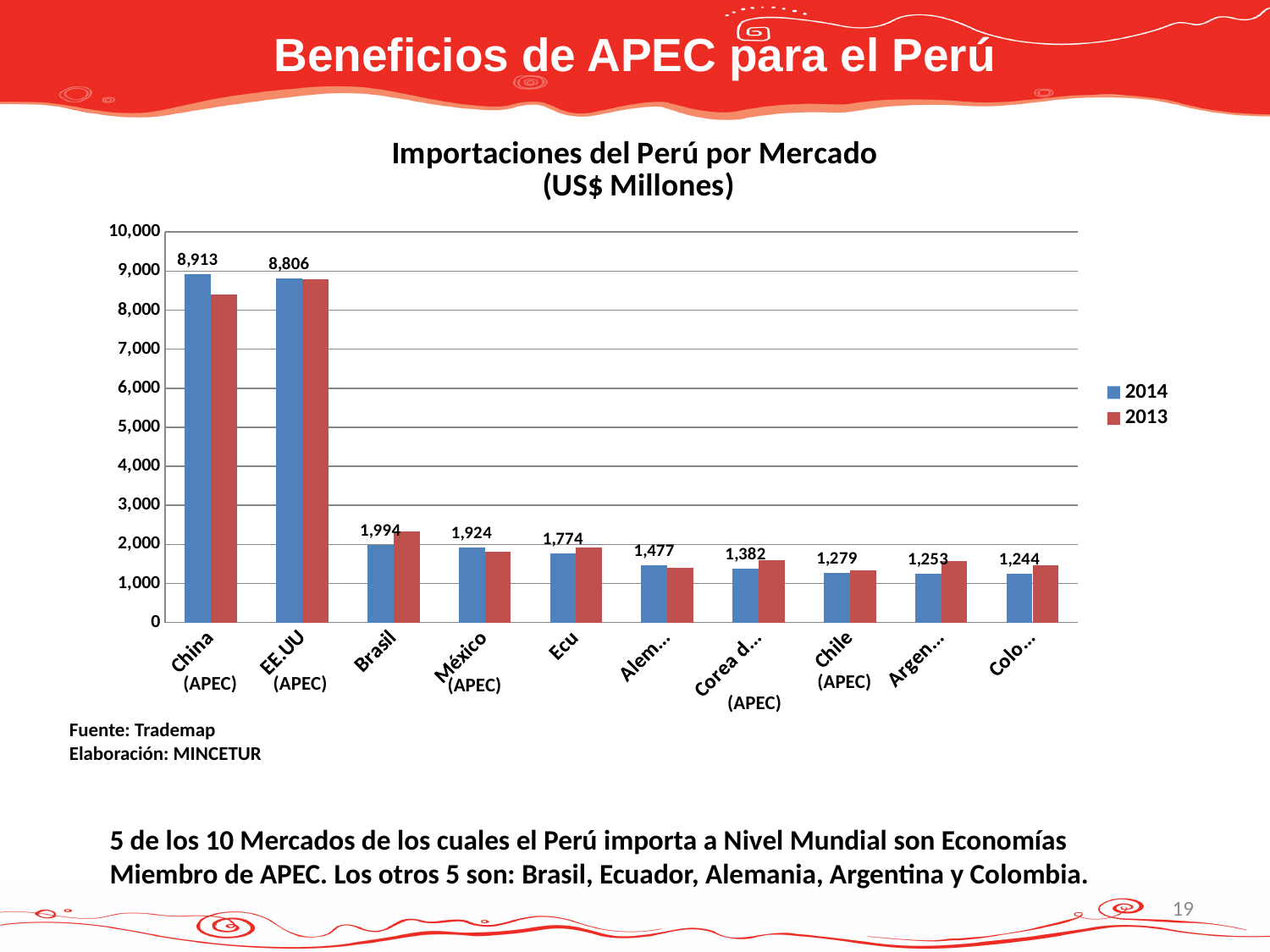
What was the 2014 import value for EE.UU shown on the chart? 8,806 Which market has the highest 2014 import value in the chart? China What is the difference between the 2014 values for Brasil and México? 70 For China, which year has the larger bar, 2014 or 2013? 2014 What was the value of Peru's imports from China in 2014, according to the chart? 8,913 Do the 2014 values rise or fall moving from left to right along the x axis? fall How many series does the legend list? 2 What is the 2014 value labelled for Brasil? 1,994 Which of the labelled markets has the lowest 2014 import value? Colombia Is the 2013 value for Brasil greater or less than 2,000? greater What is the 2014 value labelled for Chile? 1,279 What is the difference between the 2014 values for China and EE.UU? 107